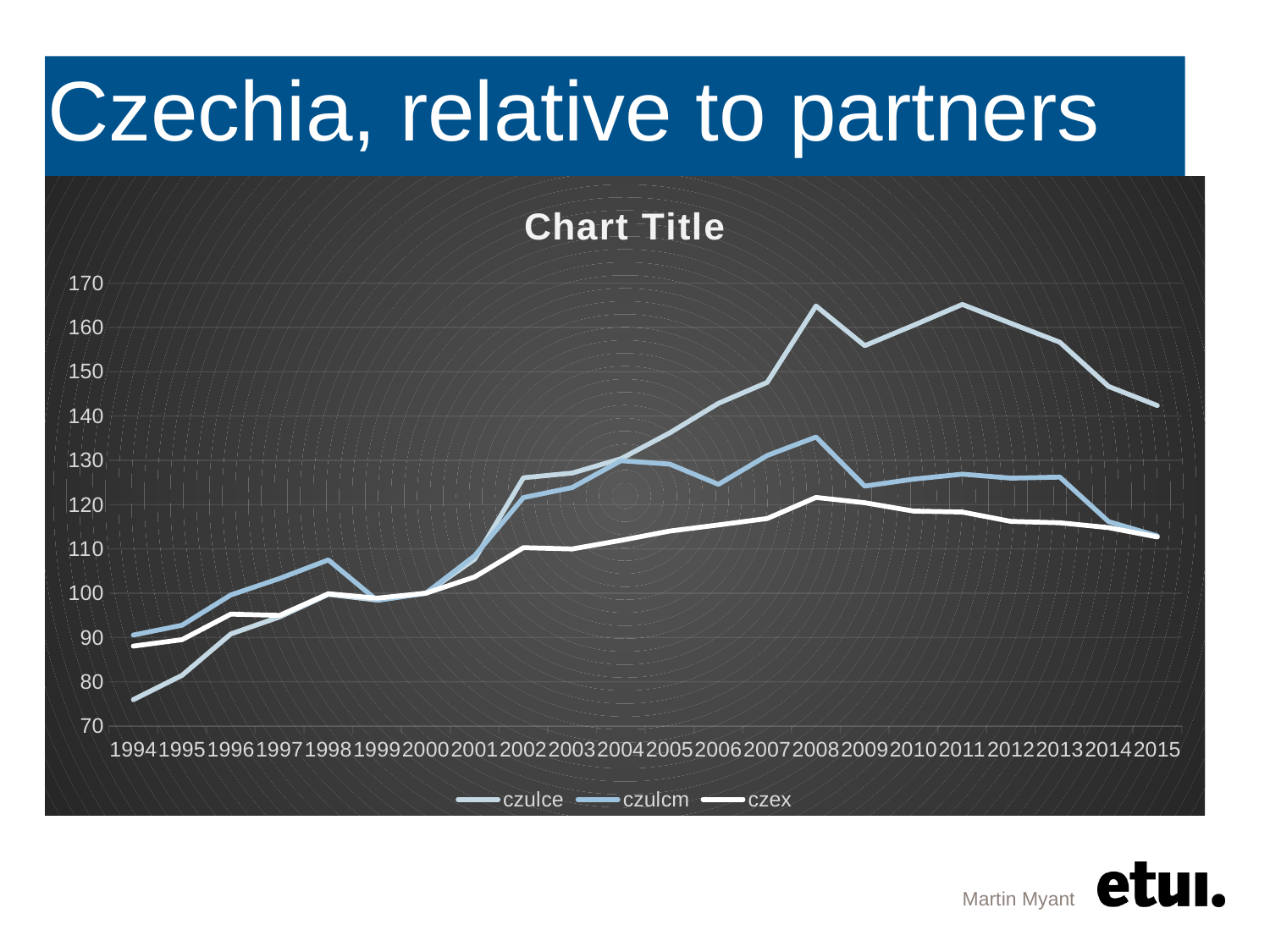
Is the value for czulce in 2008 greater or less than 160? greater Is the value for czex in 2008 greater or less than 110? greater What are the three series names listed in the legend? czulce, czulcm, czex Is the value for czex in 1994 greater or less than 100? less In which year is the czulce series at its lowest? 1994 What is the title shown above the chart? Chart Title How many years are plotted along the x axis? 22 How many series does the legend list? 3 What kind of chart is shown on the slide? line chart Does the czulce series rise or fall between 2011 and 2015? fall In 2015, which series has the larger value, czulce or czex? czulce